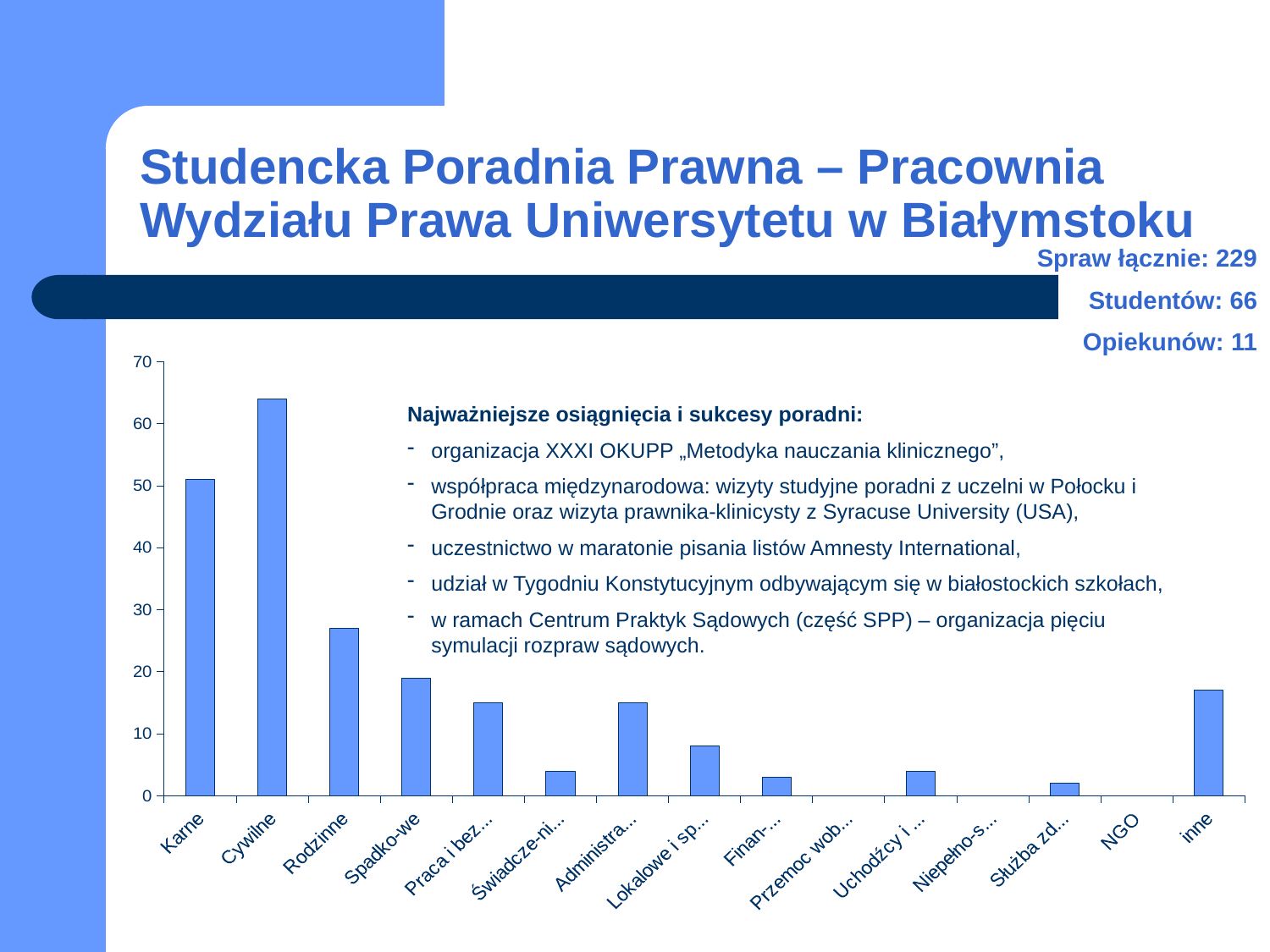
Which category has the highest bar in the chart? Cywilne Is the value for Rodzinne greater or less than 20? greater Is the value for NGO greater or less than 10? less How many categories are shown on the x axis of the chart? 15 Which is larger, the value for Karne or the value for Rodzinne? Karne Is the value for Rodzinne greater or less than 30? less Which is larger, the value for Rodzinne or the value for inne? Rodzinne What kind of chart is shown on the slide? bar chart What colour are the bars in the chart? blue